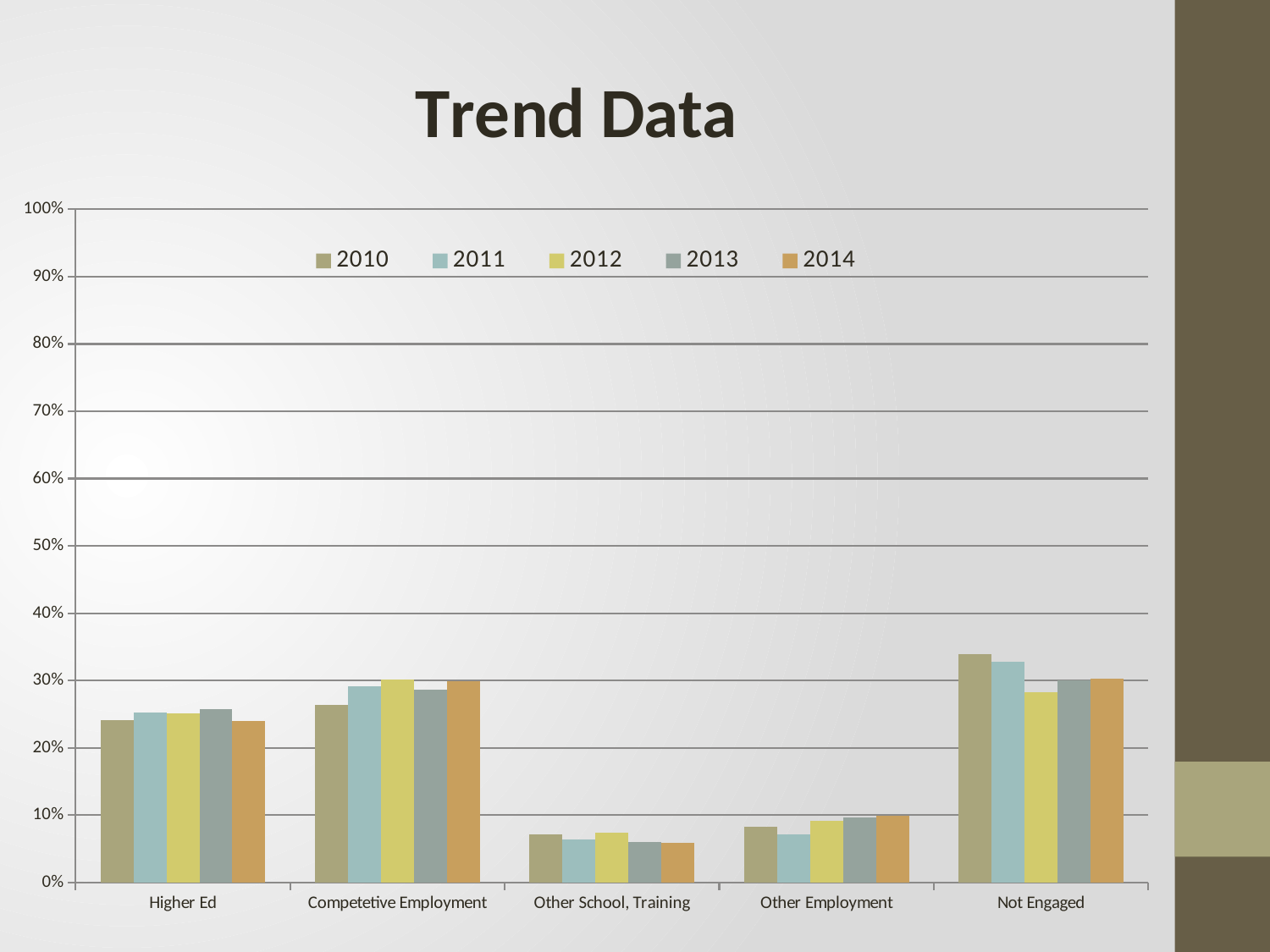
How many categories are shown along the x axis? 5 For 2014, which is larger: Other Employment or Other School, Training? Other Employment Is the 2011 value for Other School, Training greater or less than 10%? less Is the 2010 value for Higher Ed greater or less than 20%? greater Within the Not Engaged category, do the bars rise or fall from 2010 to 2012? fall What is the title of the slide? Trend Data Which category has the lowest 2014 bar? Other School, Training How many series does the legend list? 5 Which category has the highest 2010 bar? Not Engaged What kind of chart is shown on the slide? bar chart For Not Engaged, which is larger: the 2010 value or the 2012 value? 2010 Is the 2010 value for Not Engaged greater or less than 30%? greater